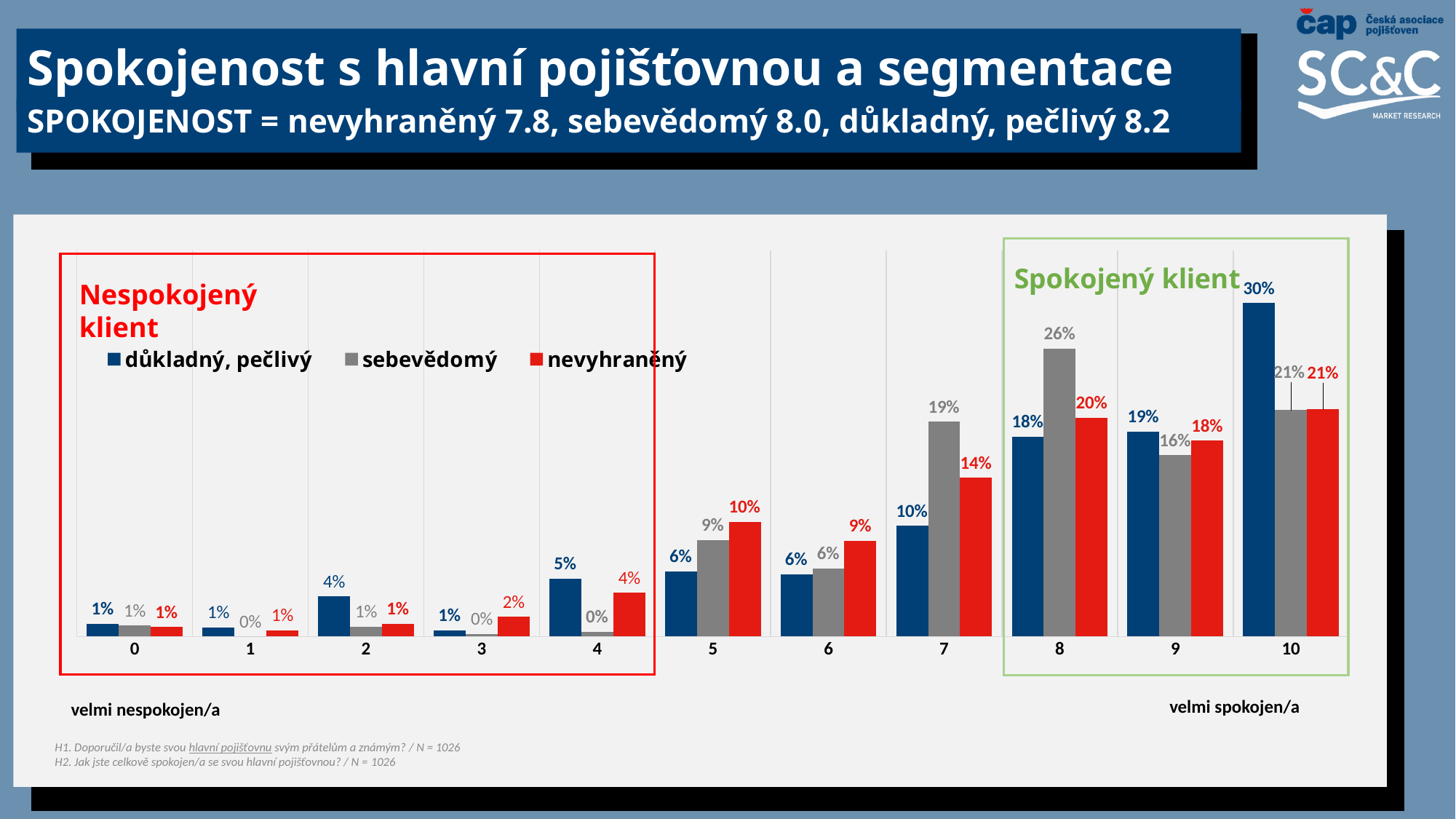
How many series does the chart legend list? 3 What is the value for 'sebevědomý' at category 8? 26% What is the value for 'důkladný, pečlivý' at category 10? 30% What is the value for 'nevyhraněný' at category 7? 14% What kind of chart is shown on the slide? bar chart What is the difference between 'důkladný, pečlivý' and 'sebevědomý' at category 10? 9% At which category does the 'důkladný, pečlivý' series reach its highest value? 10 What is the value for 'sebevědomý' at category 4? 0% How many categories are shown on the x axis of the chart? 11 At category 7, which series has the larger value: 'sebevědomý' or 'nevyhraněný'? sebevědomý Which series is shown in red in the chart legend? nevyhraněný At which category does the 'sebevědomý' series reach its highest value? 8